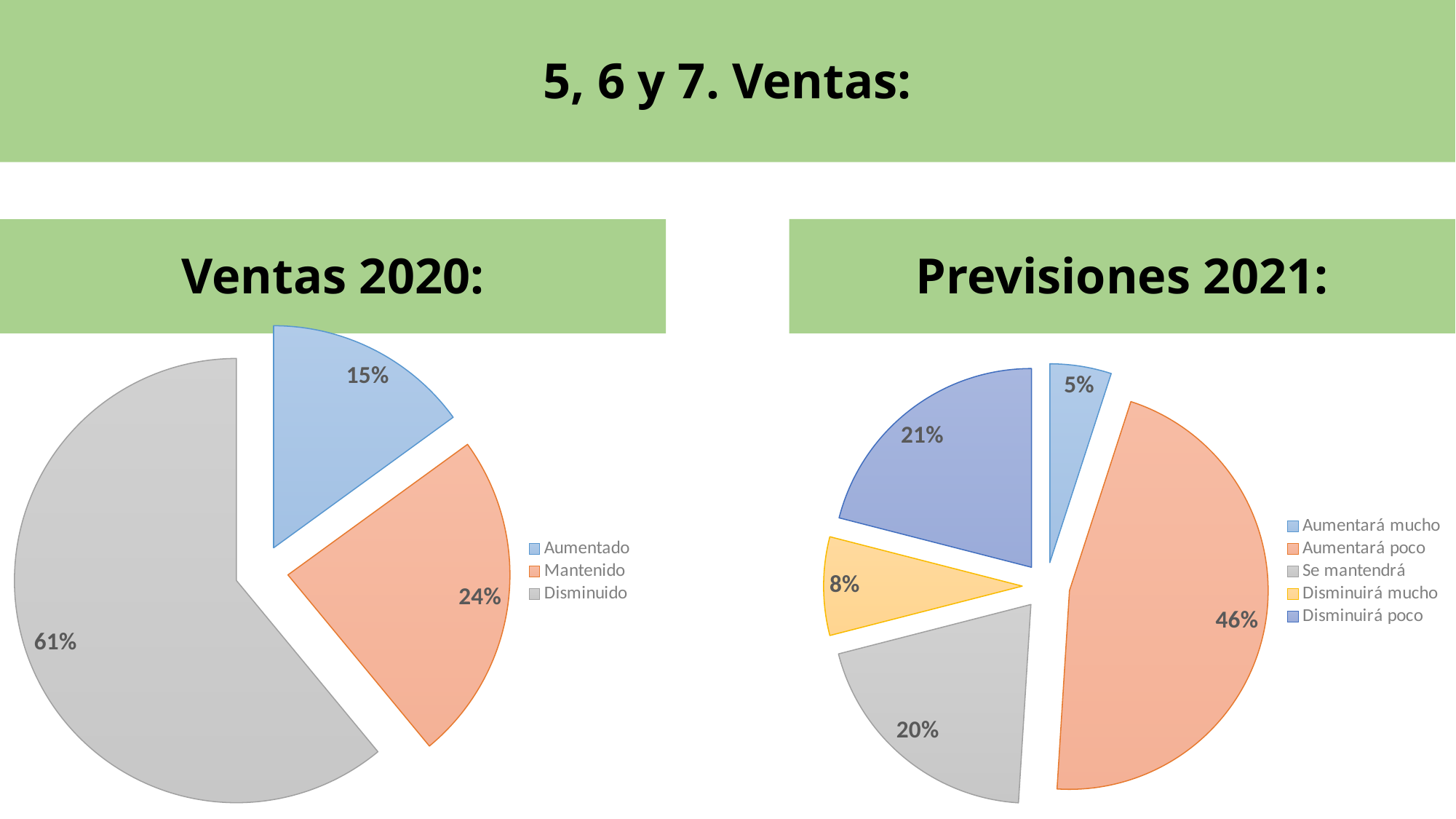
How many categories does the legend of the Previsiones 2021 chart list? 5 In the Previsiones 2021 chart, what colour is the Disminuirá mucho slice? Yellow In the Previsiones 2021 chart, what share is labelled for Disminuirá mucho? 8% In the Previsiones 2021 chart, which is larger: Se mantendrá or Disminuirá poco? Disminuirá poco In the Ventas 2020 chart, which category has the largest slice? Disminuido In the Ventas 2020 chart, what share is labelled for Aumentado? 15% In the Ventas 2020 chart, what share is labelled for Disminuido? 61% In the Ventas 2020 chart, which category has the smallest slice? Aumentado In the Previsiones 2021 chart, which category has the smallest slice? Aumentará mucho What kind of chart is the Ventas 2020 chart? Pie chart In the Ventas 2020 chart, what is the difference in percentage points between Disminuido and Mantenido? 37 In the Previsiones 2021 chart, what share is labelled for Aumentará poco? 46%